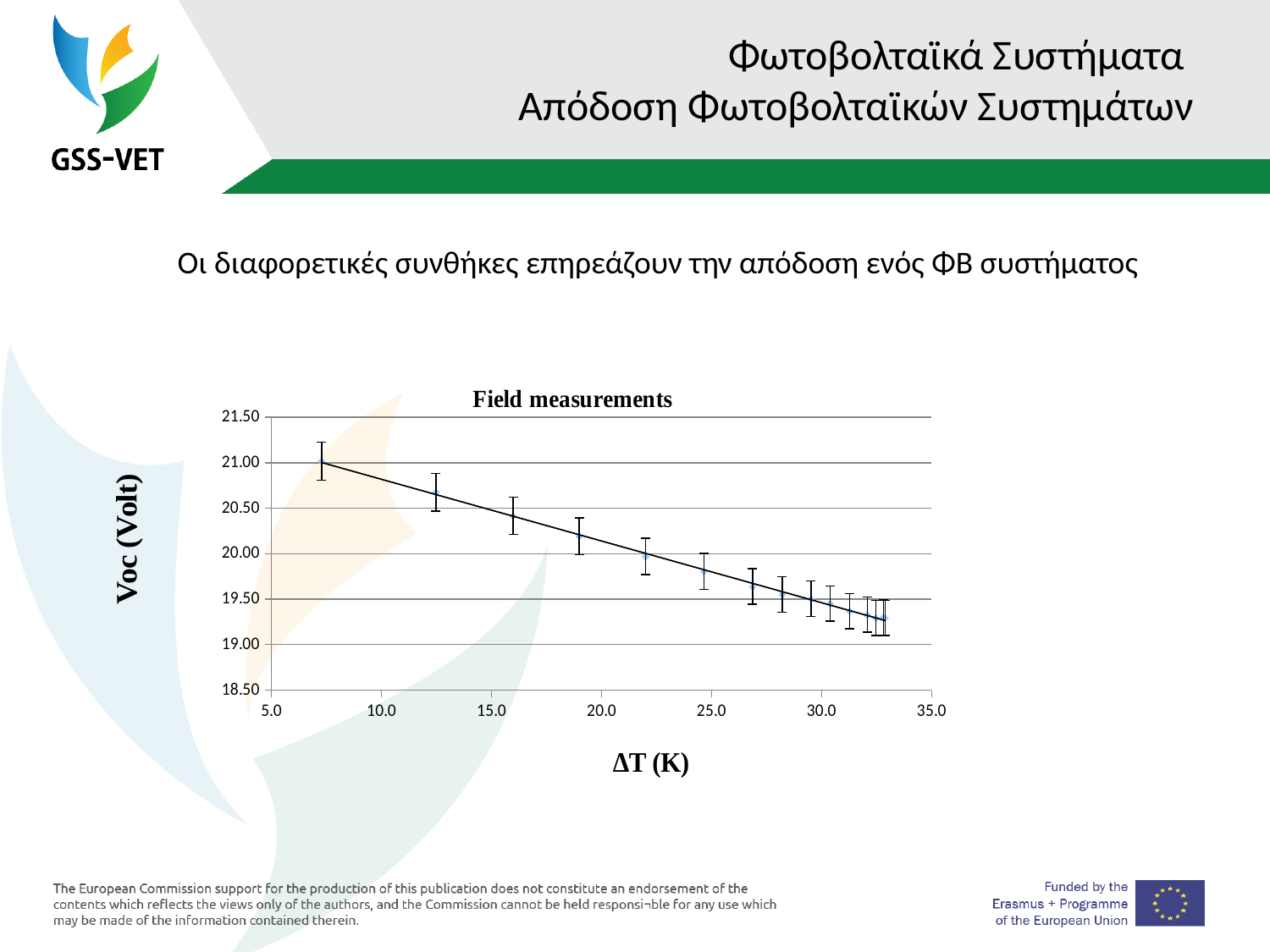
Is the Voc value at ΔT around 19 K larger or smaller than the value at ΔT around 30 K? Larger Which data point has the highest Voc: the one at the lowest ΔT or the one at the highest ΔT? The one at the lowest ΔT As ΔT increases along the x axis, does Voc rise or fall? Fall Is the Voc value at ΔT around 12.5 K greater or less than 20.50? greater What is the title of the chart? Field measurements Is the Voc value at ΔT around 27 K greater or less than 20.00? less Is the Voc value at the rightmost data point (ΔT around 33 K) greater or less than 19.50? less What is the highest value shown on the y axis of the chart? 21.50 What type of chart is shown on the slide? Line chart with error bars What is the label of the y axis of the chart? Voc (Volt)